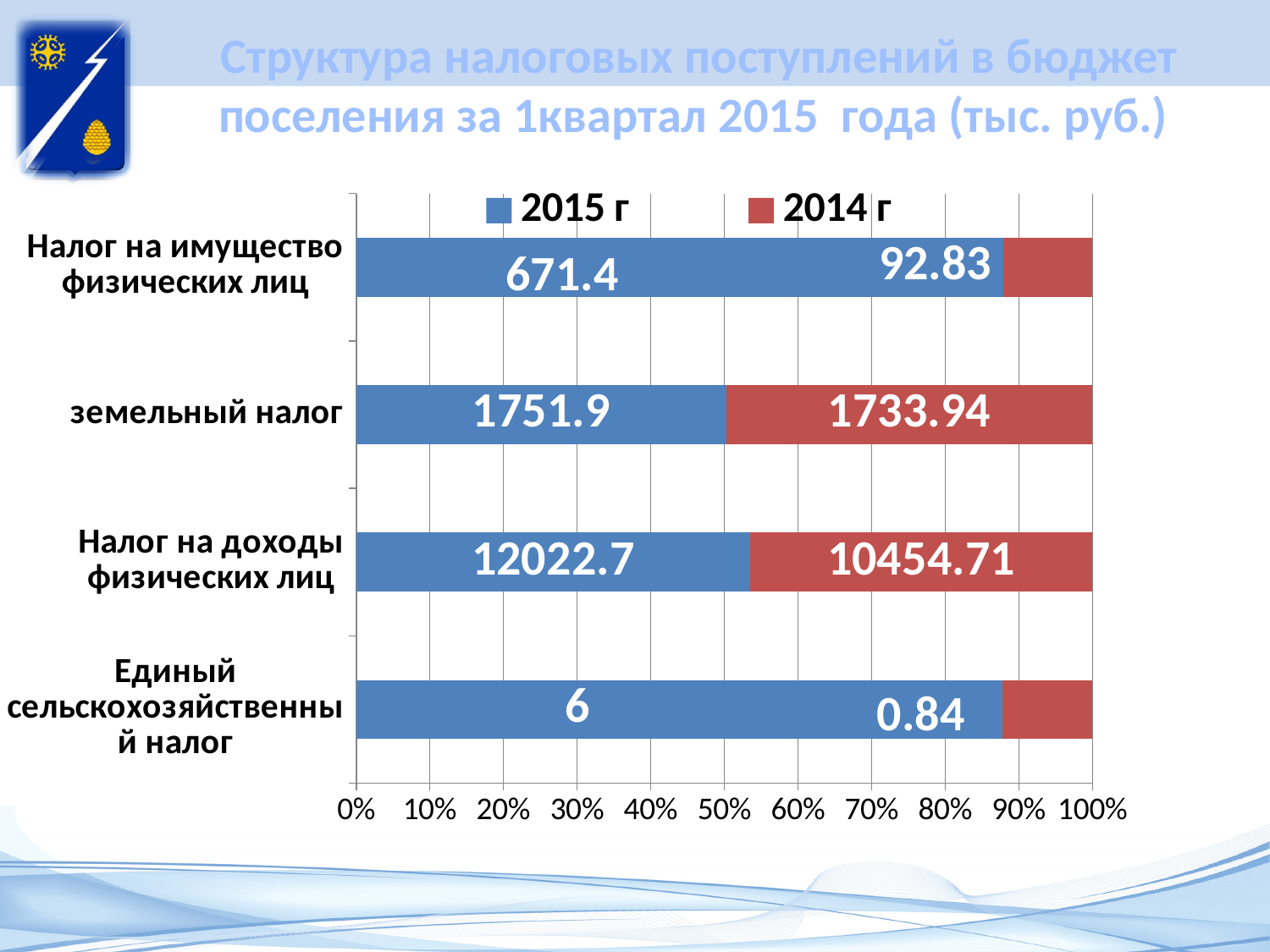
What is the 2014 г value for Налог на доходы физических лиц? 10454.71 What is the 2015 г value for земельный налог? 1751.9 What kind of chart is shown on the slide? Bar chart What is the 2015 г value for Налог на имущество физических лиц? 671.4 Which category has the lowest 2014 г value? Единый сельскохозяйственный налог How many series does the legend list? 2 What is the combined total of the 2015 г and 2014 г values for земельный налог? 3485.84 What is the difference between the 2015 г and 2014 г values for Налог на доходы физических лиц? 1567.99 For Налог на имущество физических лиц, which year has the larger value, 2015 г or 2014 г? 2015 г Which category has the highest 2015 г value? Налог на доходы физических лиц What is the 2014 г value for Единый сельскохозяйственный налог? 0.84 How many tax categories are shown on the chart? 4